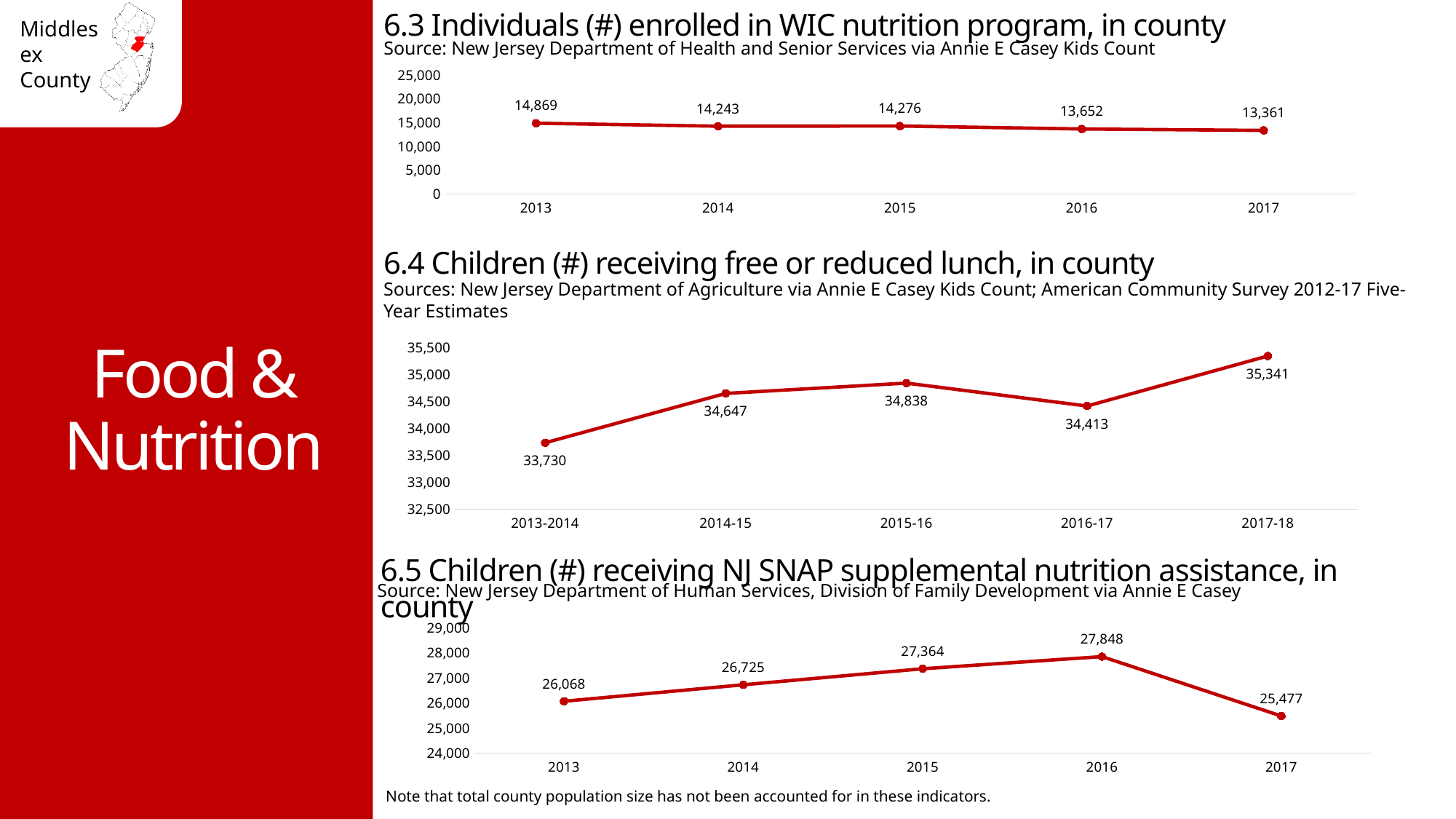
In the chart '6.5 Children (#) receiving NJ SNAP supplemental nutrition assistance, in county', which year has the lowest value? 2017 In the chart '6.3 Individuals (#) enrolled in WIC nutrition program, in county', what is the difference between the 2013 and 2017 values? 1,508 In the chart '6.4 Children (#) receiving free or reduced lunch, in county', which is larger, the value for 2014-15 or 2015-16? 2015-16 In the chart '6.3 Individuals (#) enrolled in WIC nutrition program, in county', how many data points are plotted? 5 In the chart '6.5 Children (#) receiving NJ SNAP supplemental nutrition assistance, in county', what is the difference between the 2016 and 2017 values? 2,371 In the chart '6.3 Individuals (#) enrolled in WIC nutrition program, in county', what is the value for 2013? 14,869 What kind of chart is used for '6.3 Individuals (#) enrolled in WIC nutrition program, in county'? Line chart In the chart '6.4 Children (#) receiving free or reduced lunch, in county', what is the value for 2016-17? 34,413 In the chart '6.4 Children (#) receiving free or reduced lunch, in county', which school year has the highest value? 2017-18 In the chart '6.5 Children (#) receiving NJ SNAP supplemental nutrition assistance, in county', what is the value for 2016? 27,848 In the chart '6.3 Individuals (#) enrolled in WIC nutrition program, in county', which year has the lowest value? 2017 In the chart '6.4 Children (#) receiving free or reduced lunch, in county', what is the difference between the 2017-18 and 2013-2014 values? 1,611